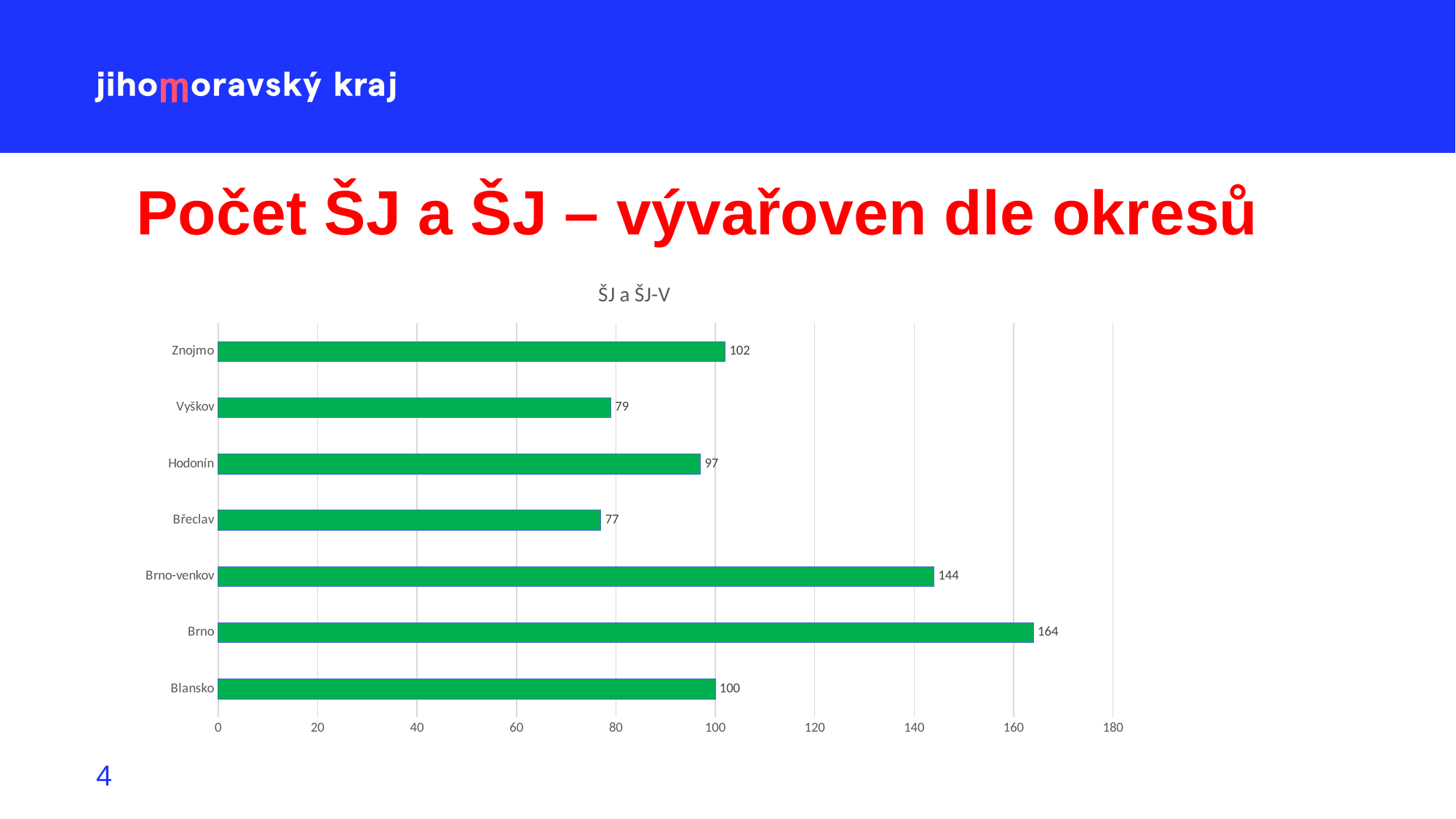
Which district has the lowest value? Břeclav What is the value for Brno? 164 Which is larger, the value for Hodonín or the value for Vyškov? Hodonín What is the difference between the values for Brno and Brno-venkov? 20 Is the value for Brno-venkov greater or less than 120? greater What is the difference between the values for Znojmo and Blansko? 2 Which district has the highest value? Brno How many districts are shown in the chart? 7 What is the value for Hodonín? 97 What is the value for Vyškov? 79 What kind of chart is shown on the slide? bar chart What is the title of the chart? ŠJ a ŠJ-V